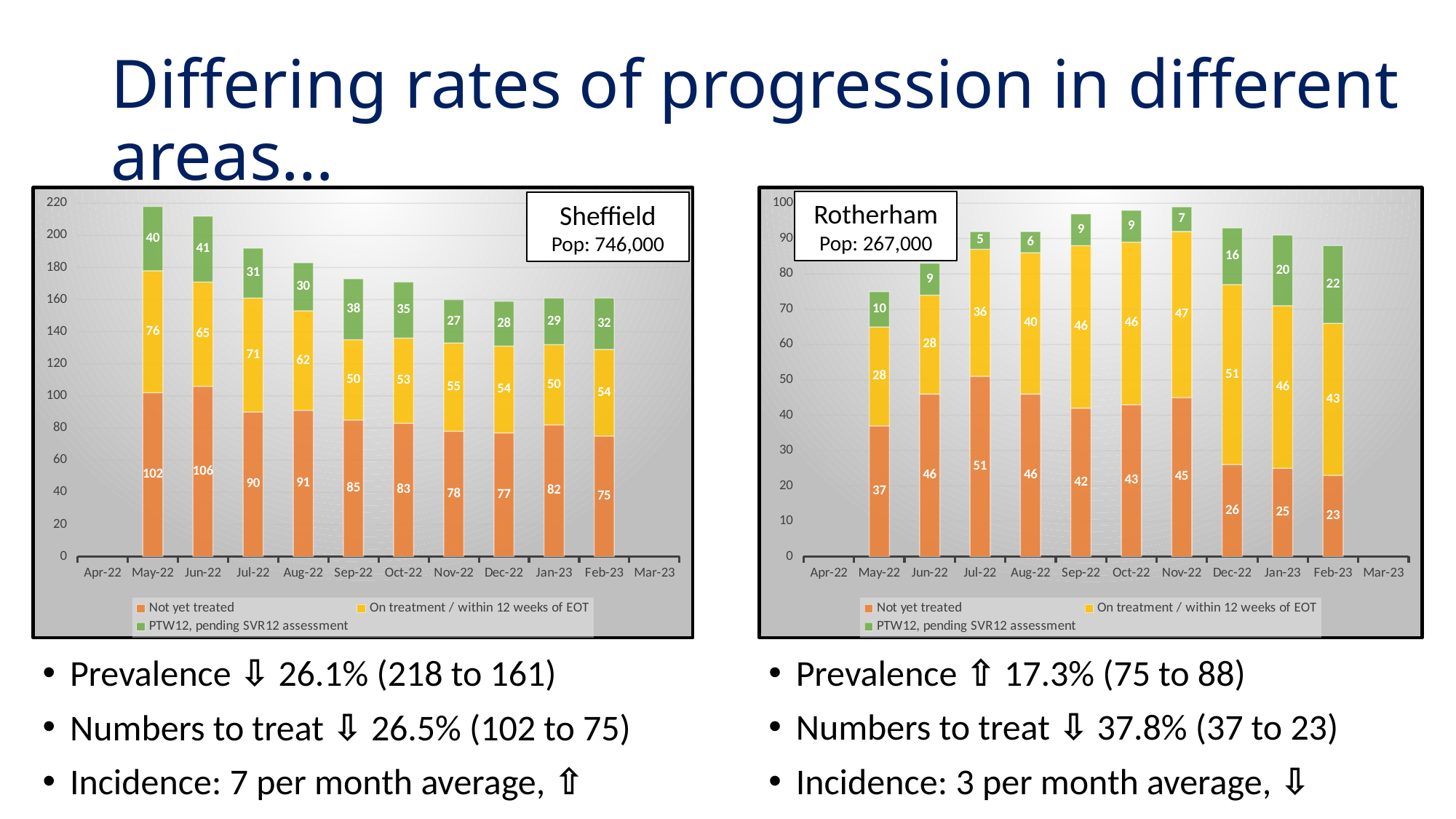
In the Rotherham chart, is the 'Not yet treated' value for Jul-22 larger or smaller than the value for Jan-23? larger What population is shown in the label box on the Rotherham chart? 267,000 In the Rotherham chart, which month has the lowest 'PTW12, pending SVR12 assessment' value? Jul-22 In the Sheffield chart, what is the total of the stacked bar for May-22? 218 How many series does the legend of the Sheffield chart list? 3 In the Sheffield chart, what is the 'Not yet treated' value for May-22? 102 In the Rotherham chart, what is the total of the stacked bar for Feb-23? 88 In the Sheffield chart, does the 'Not yet treated' value generally rise or fall from May-22 to Feb-23? Fall What kind of chart is the Rotherham chart? Stacked bar chart In the Rotherham chart, what is the 'On treatment / within 12 weeks of EOT' value for Dec-22? 51 In the Sheffield chart, what is the difference between the 'Not yet treated' values for May-22 and Feb-23? 27 In the Sheffield chart, which month has the highest 'Not yet treated' value? Jun-22